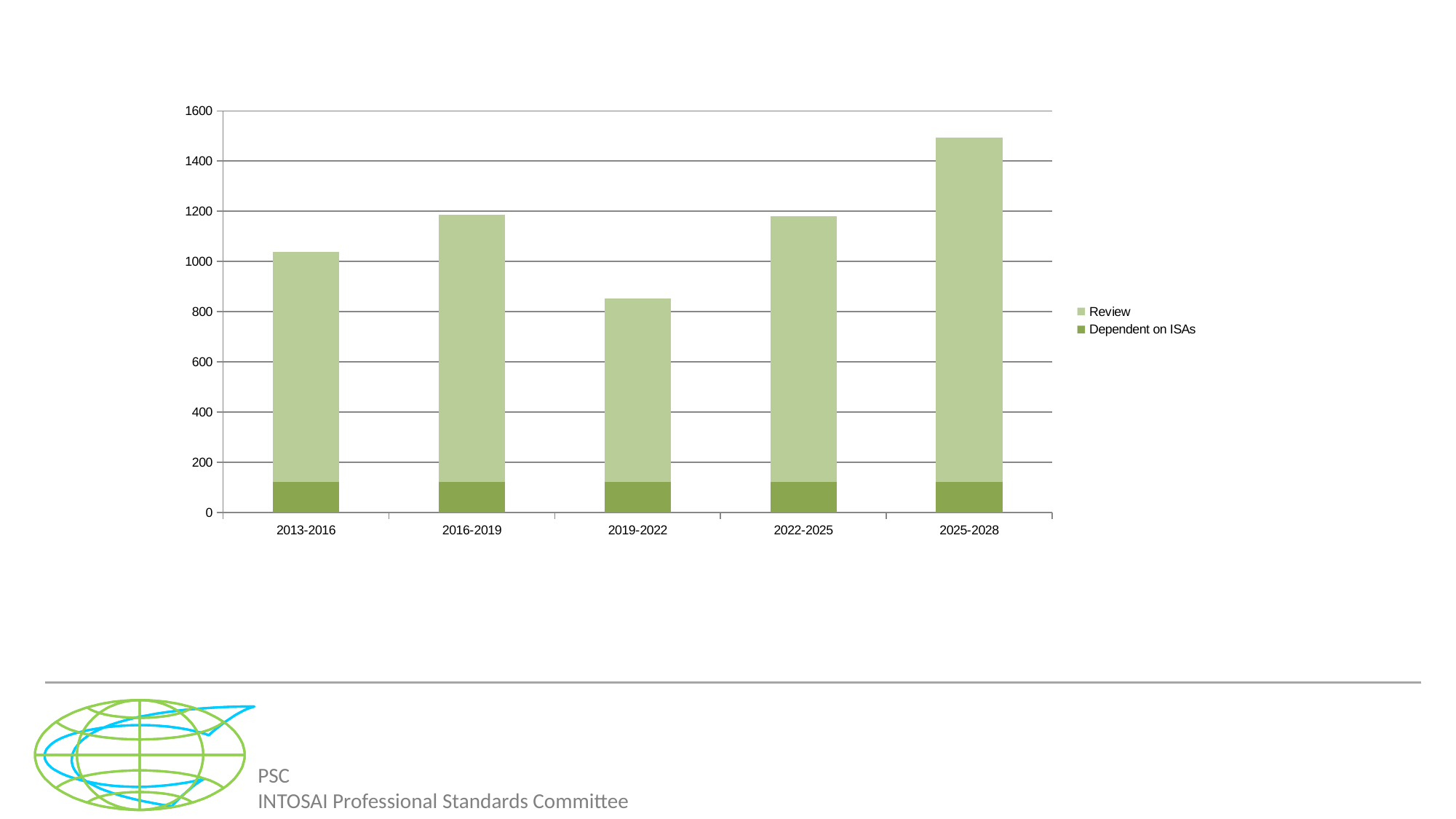
How many series does the chart's legend list? 2 What kind of chart is shown on the slide? stacked bar chart Which stacked bar is taller, 2013-2016 or 2019-2022? 2013-2016 Is the total stacked bar for 2013-2016 greater or less than 1000? greater Is the total stacked bar for 2019-2022 greater or less than 1000? less Which period has the tallest stacked bar in the chart? 2025-2028 What are the two series named in the chart's legend? Review and Dependent on ISAs Is the total stacked bar for 2025-2028 greater or less than 1400? greater How many periods are shown on the x axis of the chart? 5 Which series is shown in the darker green at the bottom of each bar? Dependent on ISAs Which period has the shortest stacked bar in the chart? 2019-2022